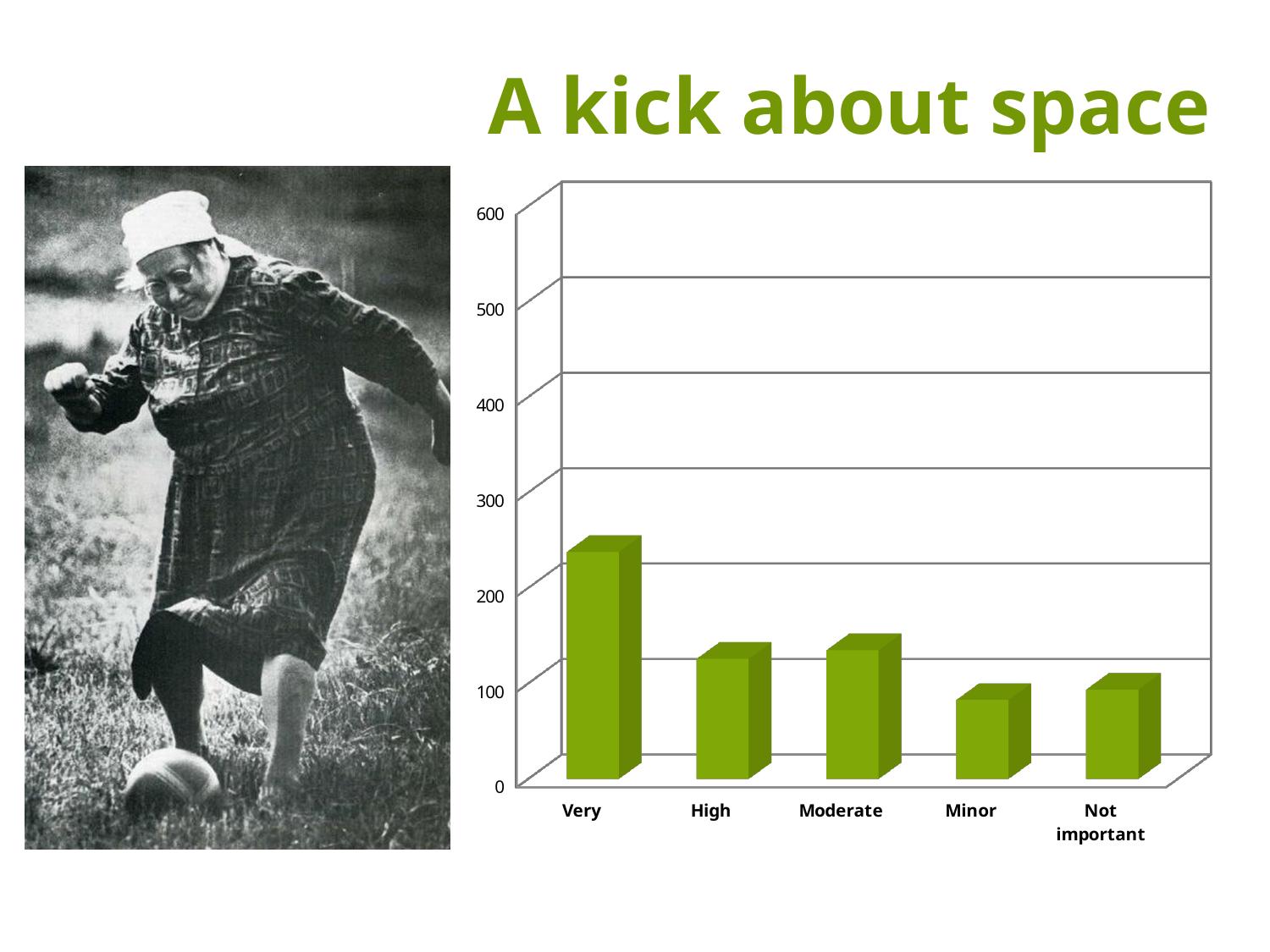
Is the value for Very greater or less than 200? greater Which is larger, the value for Moderate or the value for Minor? Moderate What colour are the bars in the chart? green How many categories are shown on the x axis of the chart? 5 What is the title of the slide containing the chart? A kick about space Which is larger, the value for Very or the value for High? Very Is the value for Minor greater or less than 100? less What kind of chart is shown on the slide? bar chart Is the value for High greater or less than 100? greater Which category has the highest value in the chart? Very